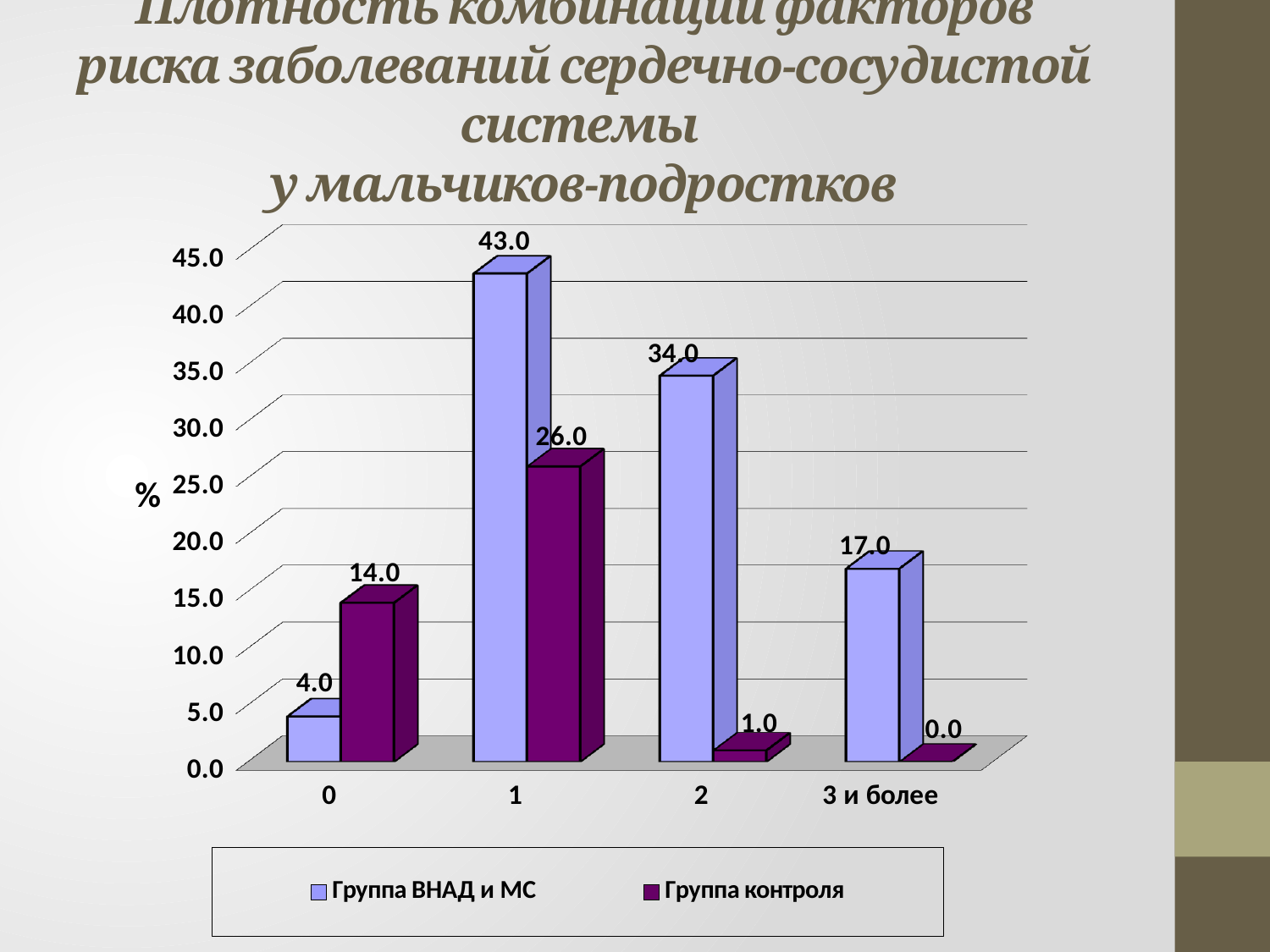
What unit is shown on the y axis label? % For category "0", which series has the larger value: "Группа ВНАД и МС" or "Группа контроля"? Группа контроля What is the value for category "0" in the "Группа контроля" series? 14.0 Which category has the highest value in the "Группа ВНАД и МС" series? 1 What is the value for category "2" in the "Группа контроля" series? 1.0 How many series does the legend list? 2 Which category has the lowest value in the "Группа контроля" series? 3 и более What is the value for category "1" in the "Группа ВНАД и МС" series? 43.0 How many categories are shown on the x axis? 4 What is the difference between the "Группа ВНАД и МС" and "Группа контроля" values for category "1"? 17.0 What is the value for category "3 и более" in the "Группа ВНАД и МС" series? 17.0 What kind of chart is shown on the slide? bar chart